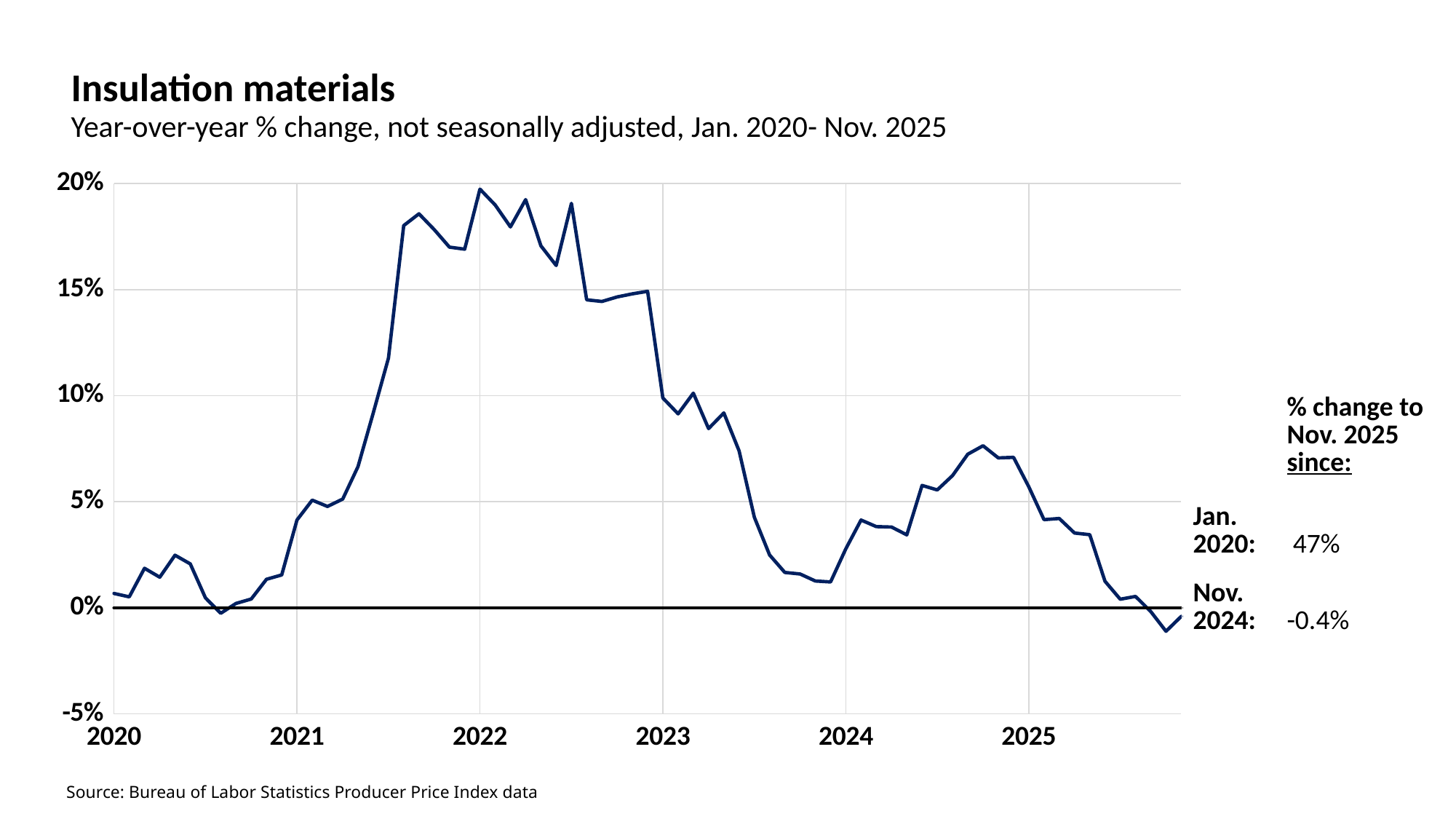
In which year does the line reach its lowest value? 2025 Does the year-over-year % change rise or fall between the start of 2022 and the start of 2024? fall What kind of chart is shown on the slide? line chart Is the year-over-year % change at the start of 2021 greater or less than 5%? less Is the year-over-year % change at the start of 2022 greater or less than 15%? greater What is the title of the chart? Insulation materials Is the year-over-year % change at the start of 2024 greater or less than 5%? less In which year does the line reach its highest value? 2022 According to the annotation on the right, what is the % change to Nov. 2025 since Jan. 2020? 47% Which is larger, the year-over-year % change at the start of 2022 or at the start of 2024? start of 2022 According to the annotation on the right, what is the % change to Nov. 2025 since Nov. 2024? -0.4%